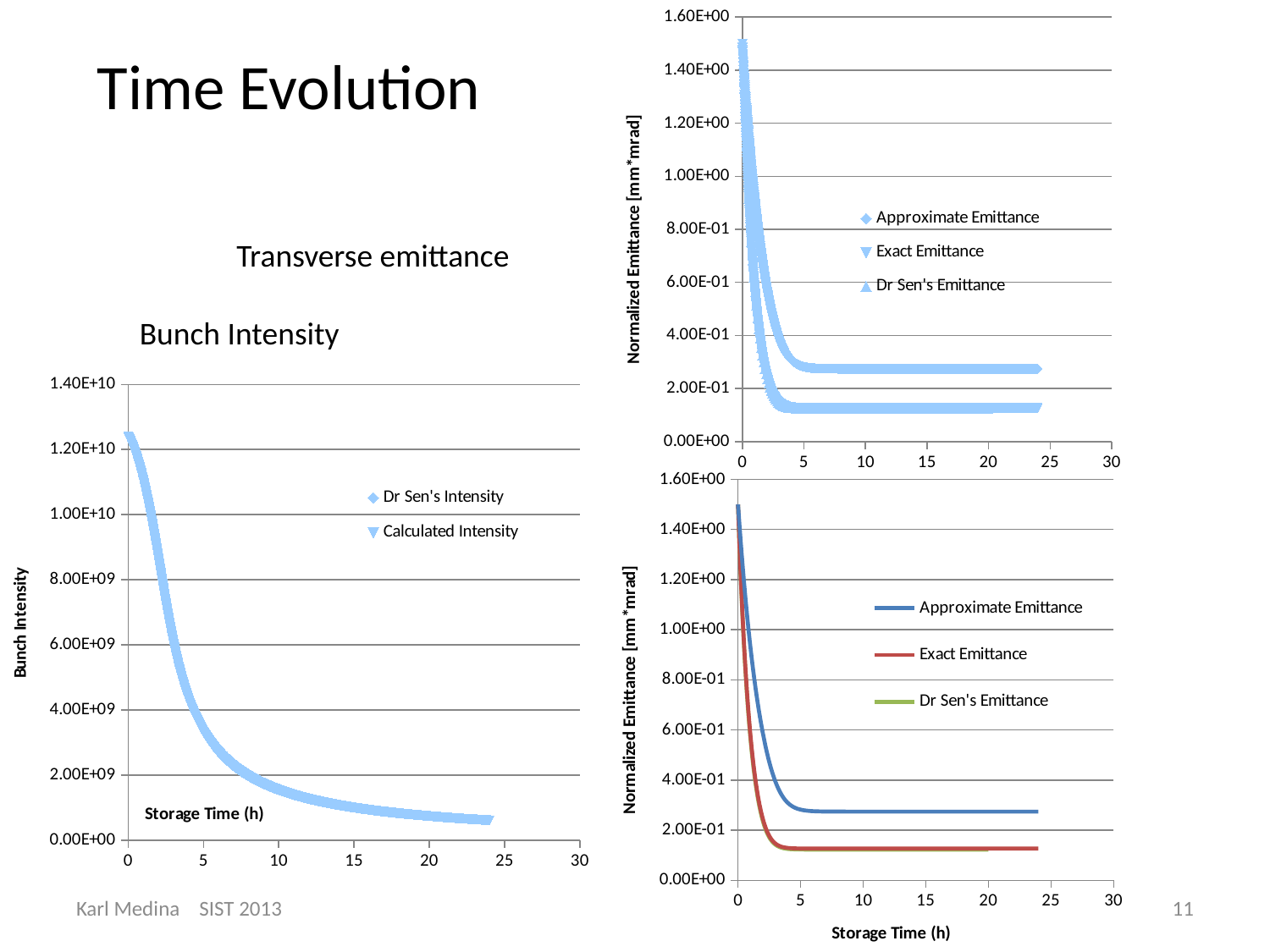
In the Bunch Intensity chart, what is the title of the y axis? Bunch Intensity In the Bunch Intensity chart, is the value at a storage time of 24 h greater or less than 1.00E+09? less In the top-right emittance chart, is the Exact Emittance value at 20 h greater or less than 2.00E-01? less In the Bunch Intensity chart, does the intensity rise or fall as storage time increases? fall In the top-right emittance chart, how many series does the legend list? 3 In the top-right emittance chart, at a storage time of 20 h, which is larger: Approximate Emittance or Exact Emittance? Approximate Emittance In the Bunch Intensity chart, is the value at a storage time of 10 h greater or less than 2.00E+09? less How many charts are on the slide? 3 In the bottom-right emittance chart, what colour is the Exact Emittance line? red What kind of chart is the bottom-right emittance chart? line chart In the Bunch Intensity chart, how many series does the legend list? 2